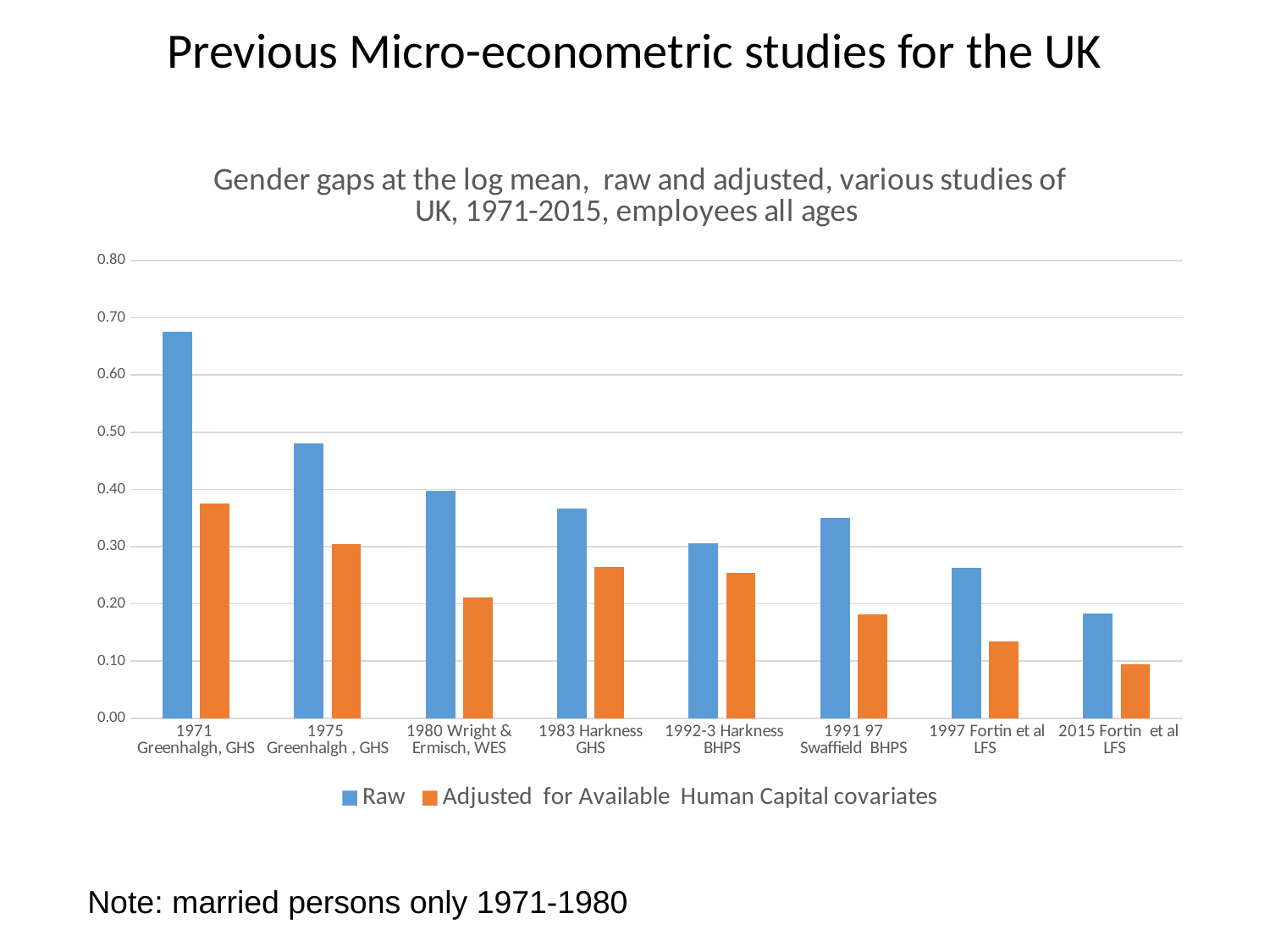
Which study has the lowest Adjusted gender gap? 2015 Fortin et al LFS Which study has the highest Raw gender gap? 1971 Greenhalgh, GHS Is the Raw value for 1971 Greenhalgh, GHS greater or less than 0.60? greater Which is larger, the Raw value for 1975 Greenhalgh, GHS or the Raw value for 1980 Wright & Ermisch, WES? 1975 Greenhalgh, GHS Is the Raw value for 1997 Fortin et al LFS greater or less than 0.30? less Which is larger, the Adjusted value for 1983 Harkness GHS or the Adjusted value for 1980 Wright & Ermisch, WES? 1983 Harkness GHS What colour are the bars for the Raw series? blue Do the Raw gender gap values generally rise or fall from 1971 to 2015 along the x axis? fall How many studies (categories) are shown along the x axis? 8 What kind of chart is shown on the slide? bar chart How many series does the legend list? 2